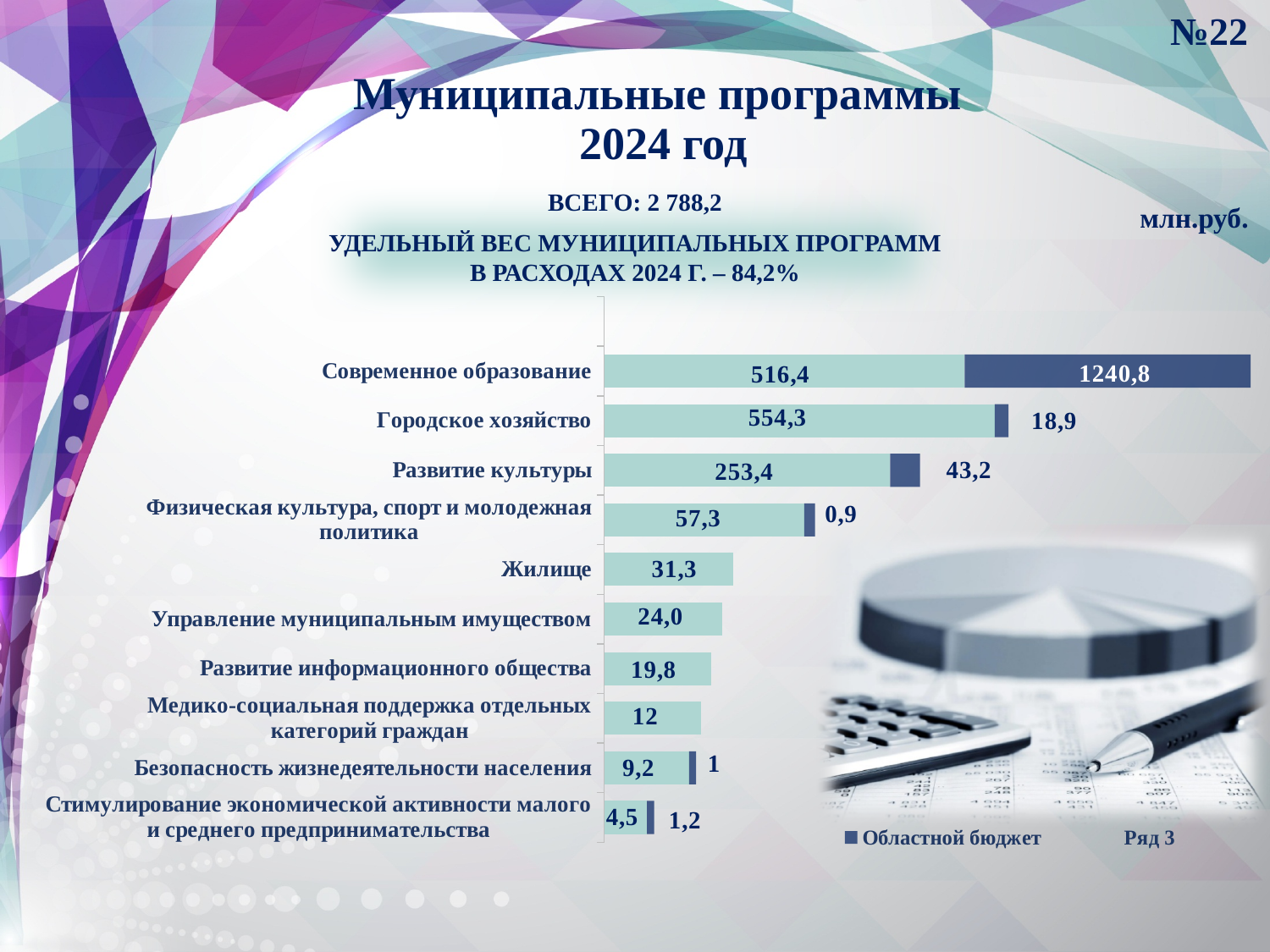
How many categories are shown in the chart? 10 What value is labelled on the Жилище bar? 31,3 What is the difference between the values for Жилище and Управление муниципальным имуществом? 7,3 Which category has the largest Областной бюджет value? Современное образование What value is labelled on the bar for Медико-социальная поддержка отдельных категорий граждан? 12 What is the value of the light teal segment for Городское хозяйство? 554,3 Which is larger: the value for Развитие информационного общества or for Медико-социальная поддержка отдельных категорий граждан? Развитие информационного общества What is the total of the two segments for Развитие культуры? 296,6 How many series does the legend list? 2 What is the Областной бюджет value for Современное образование? 1240,8 What kind of chart is shown on the slide? Stacked bar chart What is the Областной бюджет value for Безопасность жизнедеятельности населения? 1